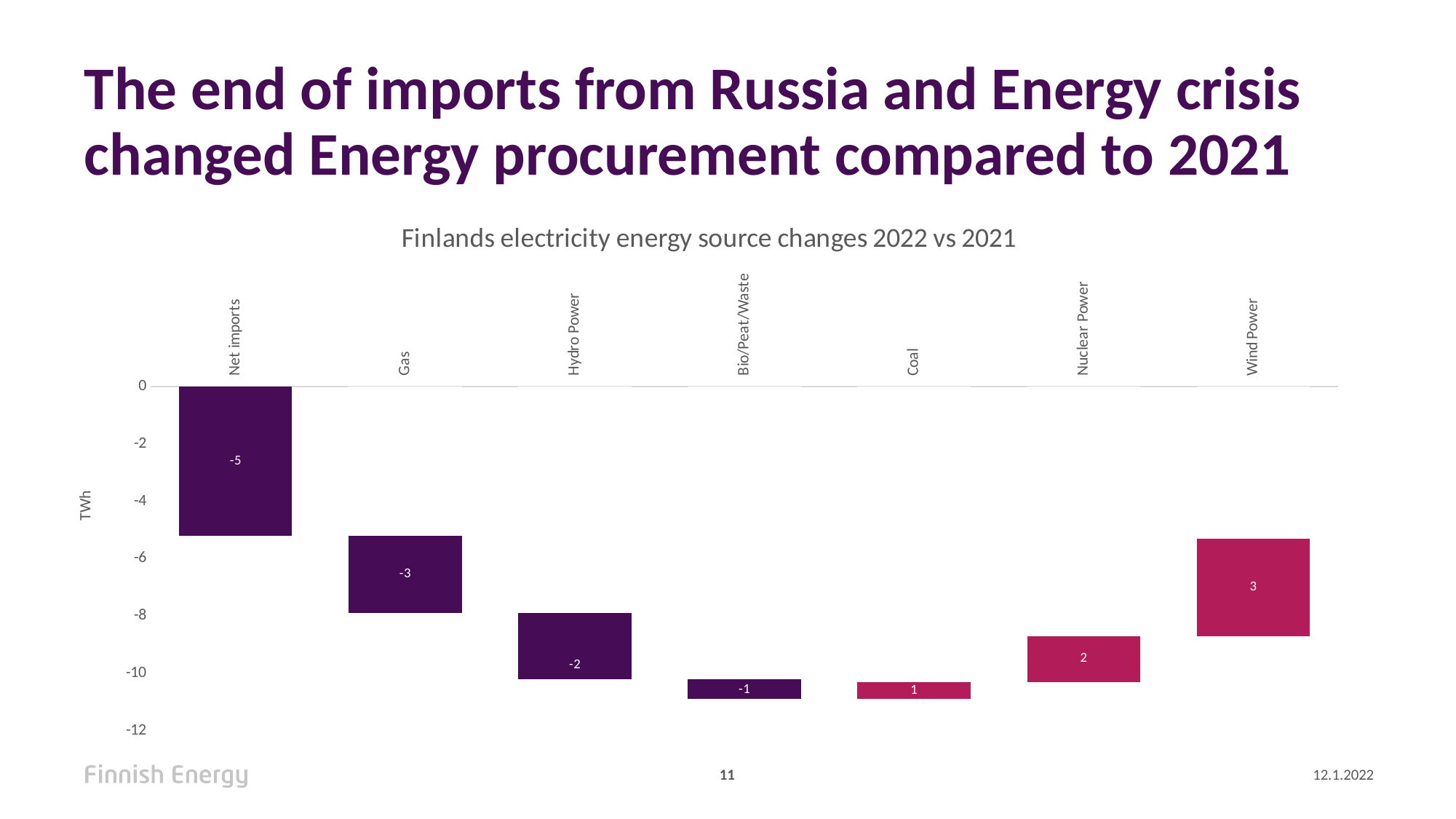
What is the value for Gas? -3 What is the difference between the values for Nuclear Power and Coal? 1 What is the value for Wind Power? 3 What unit is shown on the vertical axis of the chart? TWh Which category has the highest value? Wind Power What is the value for Net imports? -5 How many categories are shown in the chart? 7 Which is larger, the value for Nuclear Power or the value for Hydro Power? Nuclear Power What is the value for Bio/Peat/Waste? -1 What is the value for Coal? 1 What is the difference between the values for Wind Power and Net imports? 8 Which category has the lowest value? Net imports